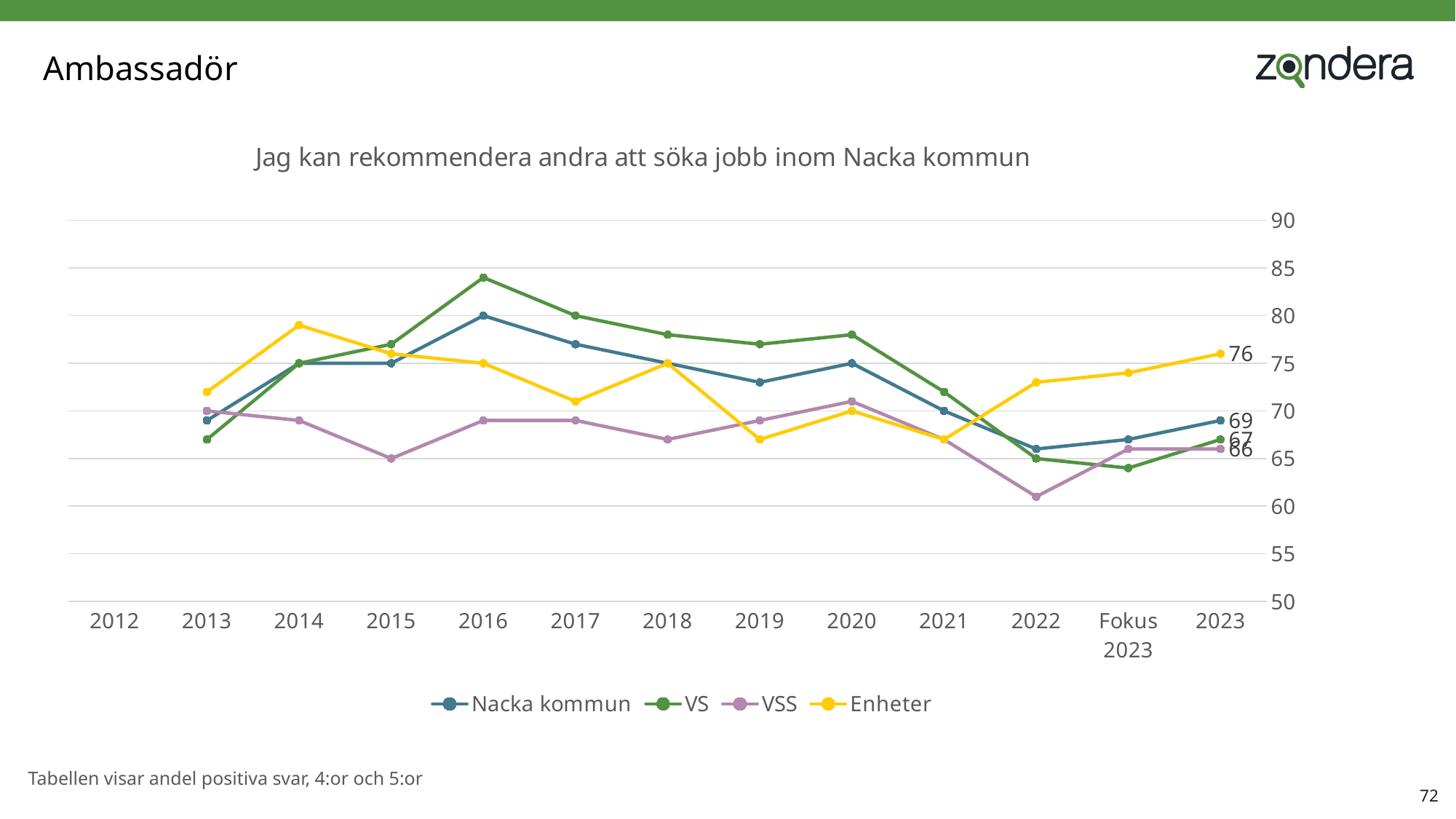
Does the Enheter line rise or fall from 2021 to 2023? rise Which is larger in 2023, the value for Nacka kommun or the value for VS? Nacka kommun What is the value for VSS in 2023? 66 How many series does the legend list? 4 Which series has the lowest value in 2023? VSS What is the value for Enheter in 2023? 76 What is the difference between the Enheter and Nacka kommun values in 2023? 7 What type of chart is shown on the slide? line chart Is the value for VS in 2016 greater or less than 80? greater Which series has the highest value in 2023? Enheter Is the value for VSS in 2022 greater or less than 65? less What is the value for Nacka kommun in 2023? 69